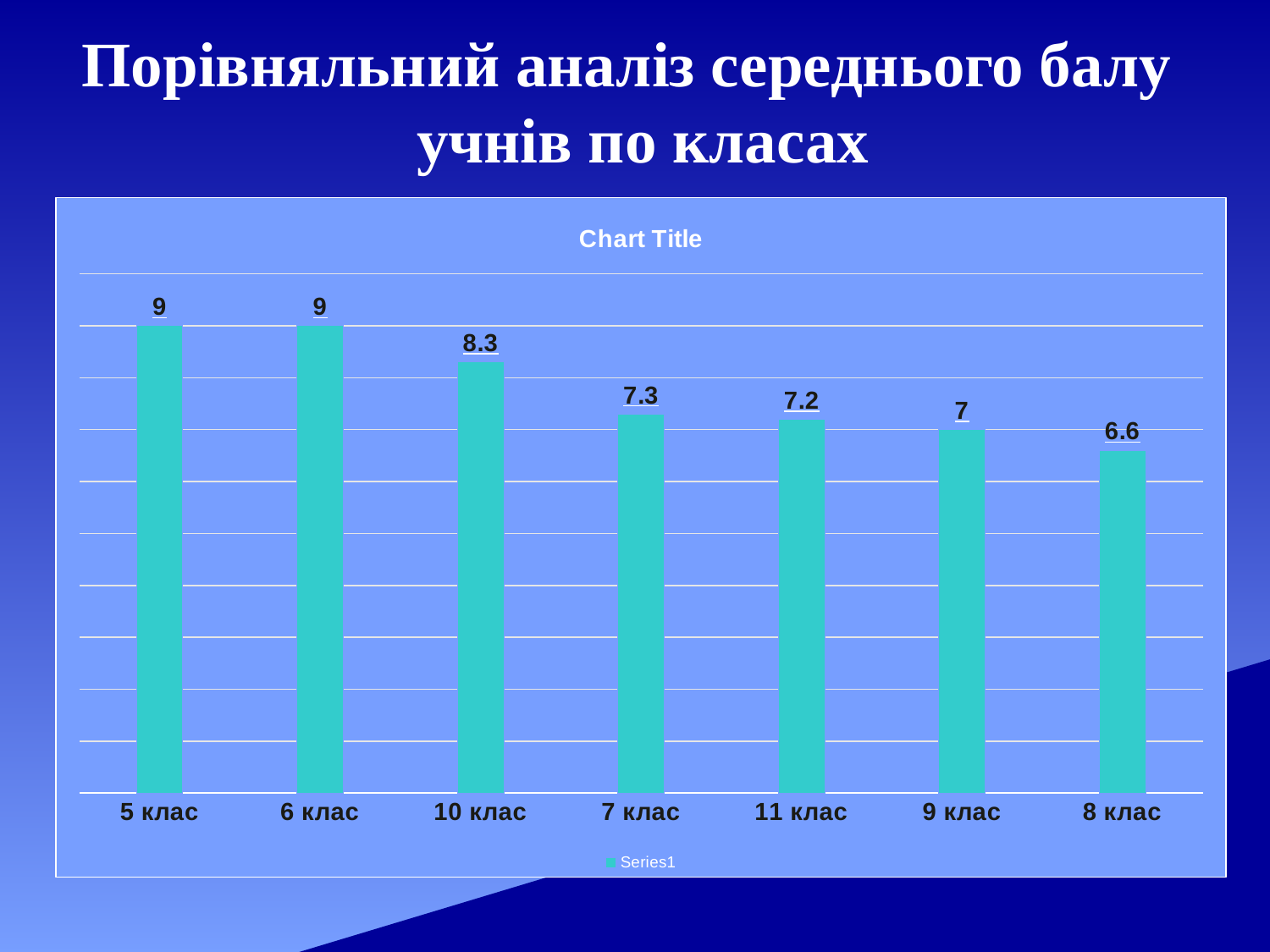
What is the difference between the values for 10 клас and 7 клас? 1 What is the value for 10 клас? 8.3 What is the value for 8 клас? 6.6 What is the name of the series in the legend? Series1 How many categories are shown on the x axis? 7 What kind of chart is shown? bar chart What is the value for 9 клас? 7 What is the difference between the values for 5 клас and 8 клас? 2.4 What is the value for 11 клас? 7.2 Which is larger, the value for 7 клас or the value for 9 клас? 7 клас How many series does the legend list? 1 Which category has the lowest value? 8 клас